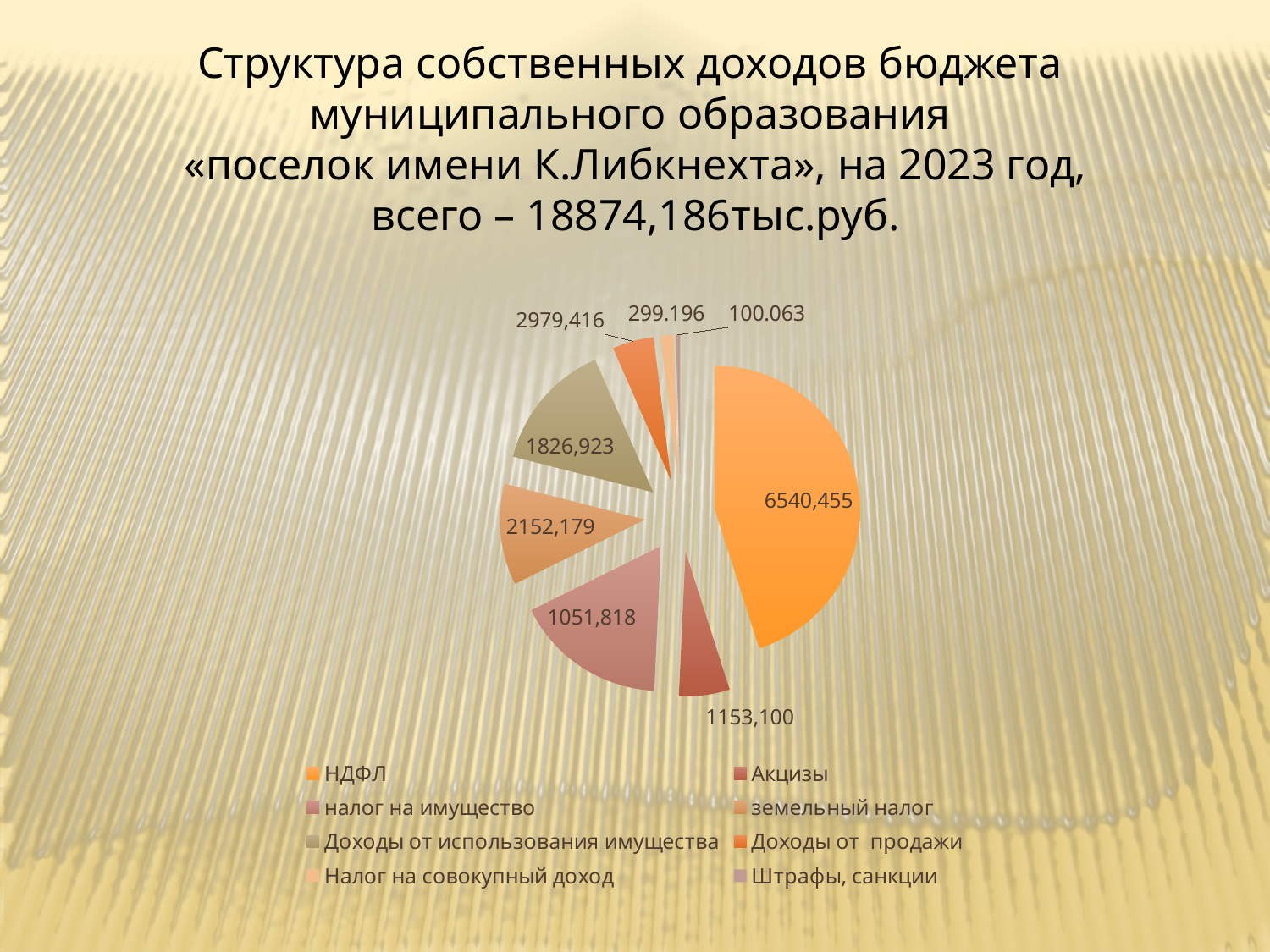
What is the value shown for налог на имущество? 1051,818 How many categories does the pie chart have? 8 What is the value shown for земельный налог? 2152,179 Which category has the largest slice of the pie? НДФЛ Which category has the smallest slice of the pie? Штрафы, санкции What is the value shown for НДФЛ? 6540,455 What type of chart is shown on the slide? pie chart According to the slide title, what is the total of own budget revenues for 2023? 18874,186тыс.руб. What is the value shown for Акцизы? 1153,100 What is the value shown for Штрафы, санкции? 100.063 What is the difference between the values for НДФЛ and Акцизы? 5387,355